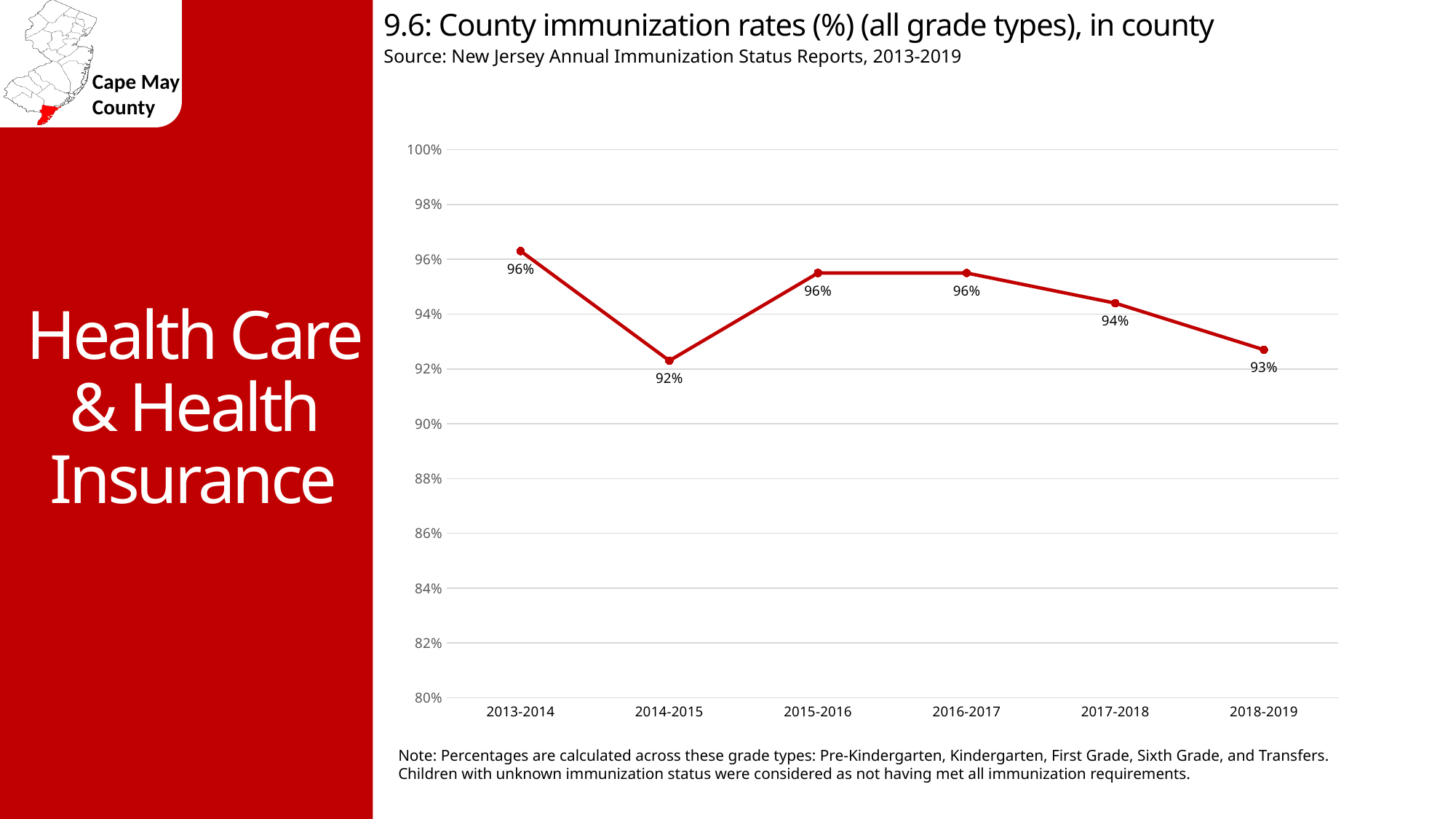
What was the county immunization rate in 2014-2015? 92% How many school years are plotted on the chart? 6 What was the county immunization rate in 2017-2018? 94% What was the county immunization rate in 2013-2014? 96% What is the source cited for the chart data? New Jersey Annual Immunization Status Reports, 2013-2019 Which school year had the lowest county immunization rate? 2014-2015 What kind of chart is shown on the slide? line chart Is the immunization rate for 2014-2015 greater or less than 94%? less Which year had a higher immunization rate, 2017-2018 or 2018-2019? 2017-2018 What was the county immunization rate in 2018-2019? 93% What is the difference between the immunization rate in 2013-2014 and in 2014-2015? 4 percentage points Does the immunization rate rise or fall from 2016-2017 to 2018-2019? fall